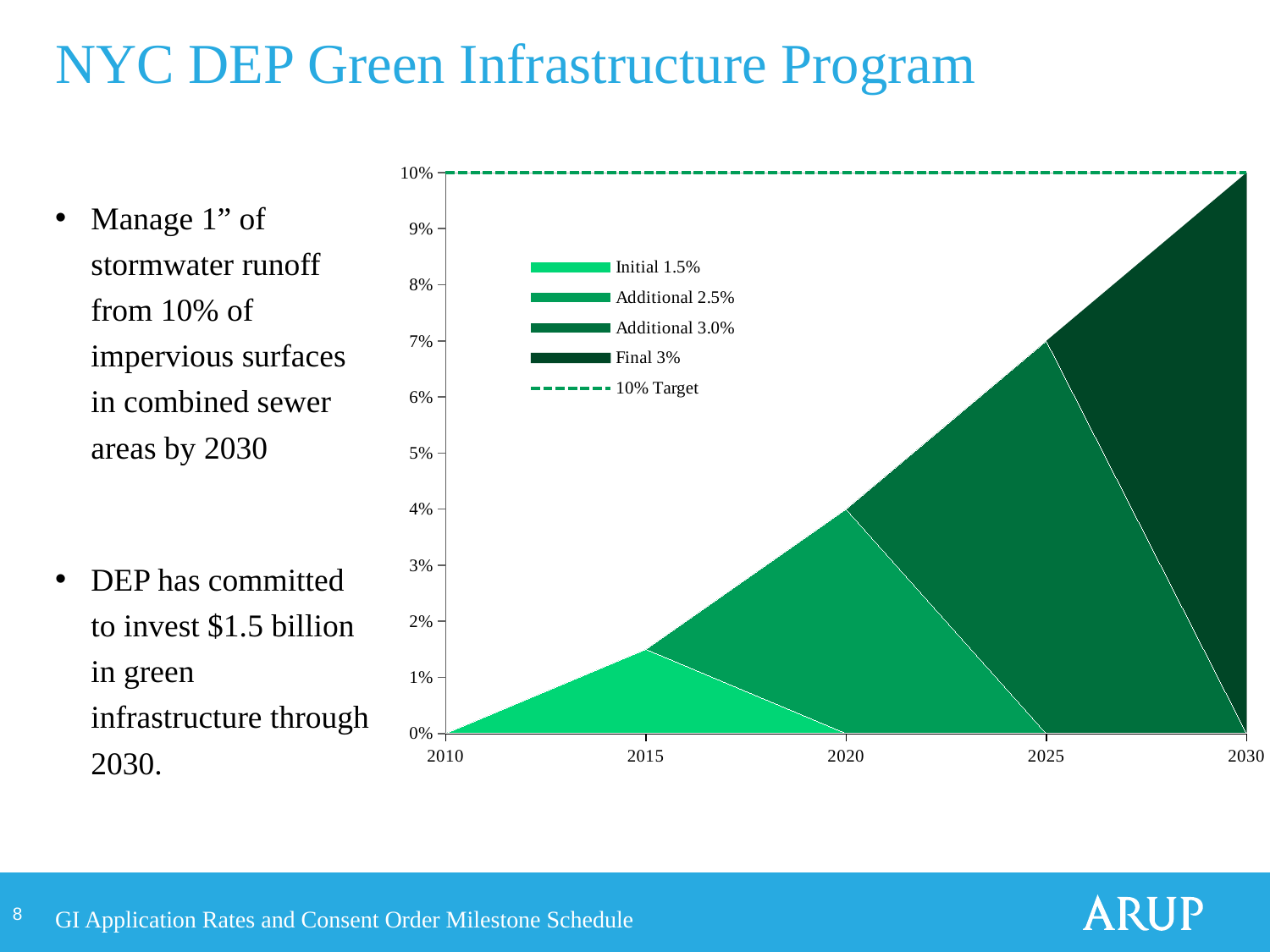
Do the cumulative values rise or fall from 2010 to 2030? rise What is the difference between the cumulative value in 2030 and the cumulative value in 2020? 6% Is the cumulative value in 2015 greater or less than 2%? less How many entries does the chart legend list? 5 At what level is the dashed 10% Target line drawn? 10% What cumulative percentage does the stacked area reach in 2025? 7% What cumulative percentage does the stacked area reach in 2020? 4% How many year labels are shown on the x axis of the chart? 5 What kind of chart is shown on the slide? area chart Which is larger, the cumulative value in 2025 or in 2020? 2025 What cumulative percentage does the stacked area reach in 2030? 10% Which legend entry is represented by the dashed line? 10% Target